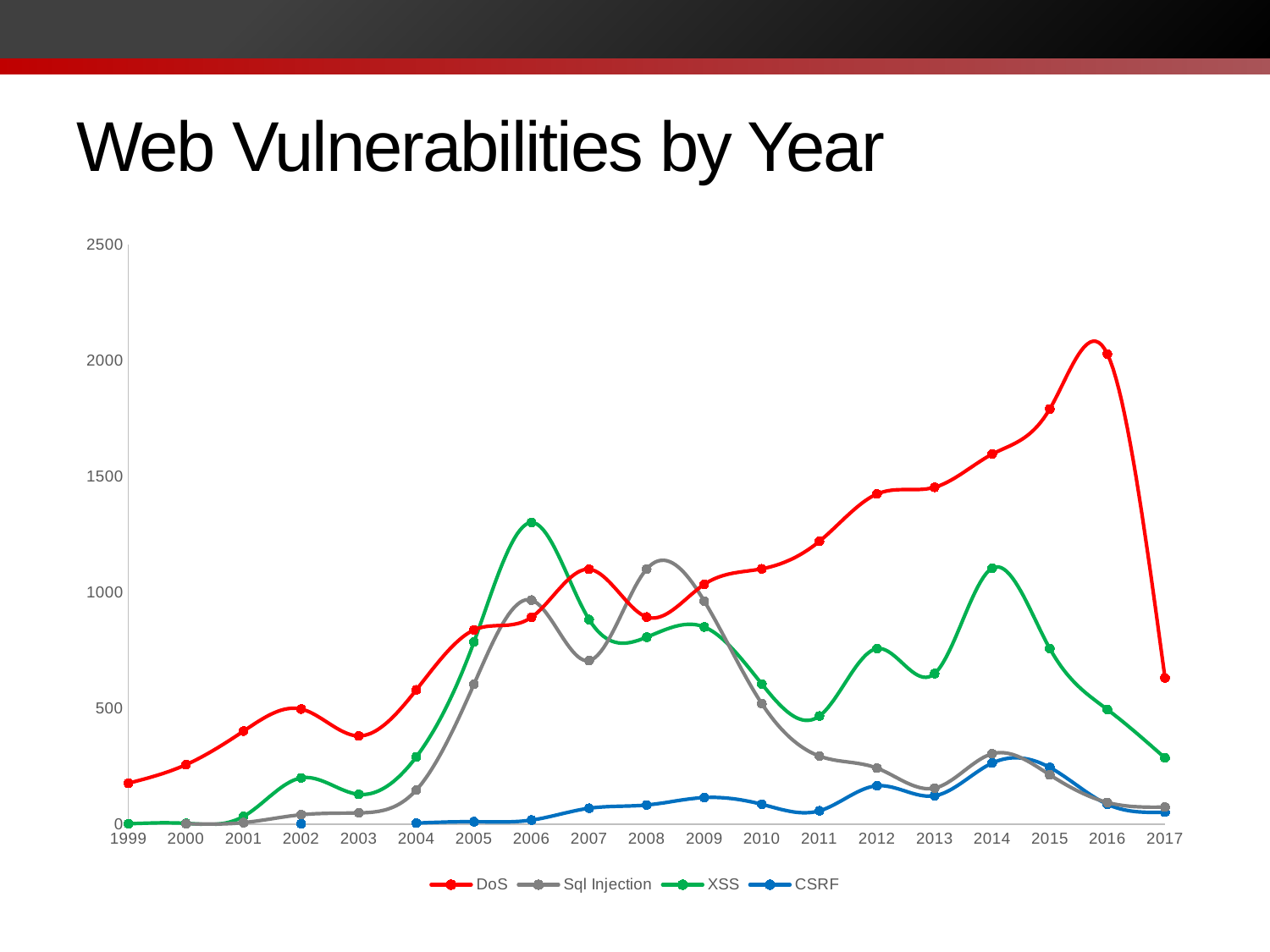
What is the title of the chart? Web Vulnerabilities by Year How many series does the legend list? 4 Which is larger in 2006, XSS or Sql Injection? XSS Is the value for DoS in 2015 greater or less than 1500? greater How many years are plotted along the x axis? 19 Which series has the highest value in 2016? DoS What kind of chart is shown on the slide? line chart Is the value for CSRF in 2014 greater or less than 500? less In which year does the DoS series reach its highest value? 2016 Is the value for XSS in 2006 greater or less than 1000? greater Does the DoS series rise or fall between 2009 and 2016? rise Which is larger in 2014, DoS or XSS? DoS